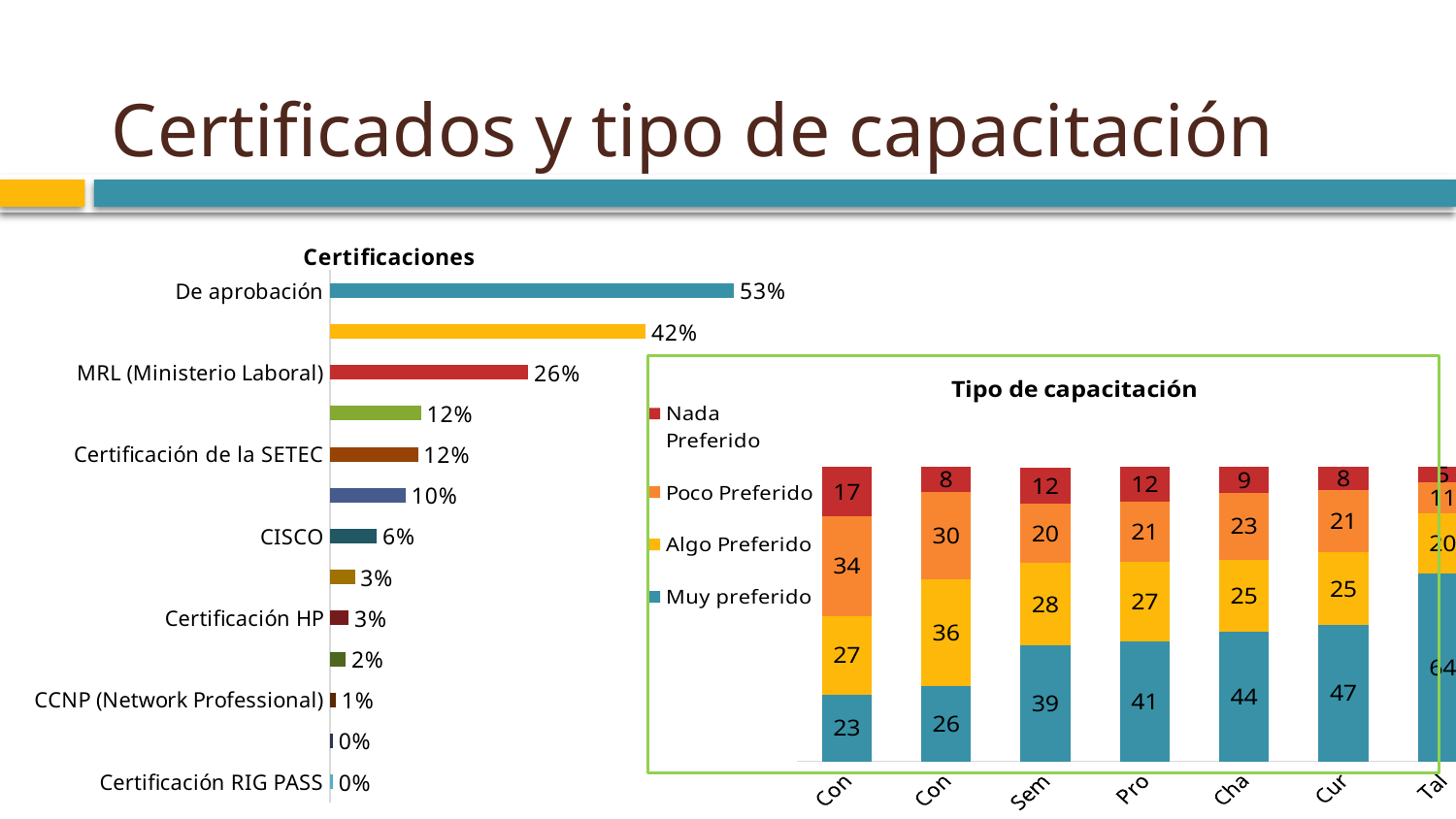
In the Tipo de capacitación chart, what is the total of the third bar from the left (labelled Sem)? 99 In the Tipo de capacitación chart, do the Muy preferido values rise or fall from left to right? Rise In the Certificaciones chart, what is the value for MRL (Ministerio Laboral)? 26% In the Certificaciones chart, which is larger: Certificación de la SETEC or Certificación HP? Certificación de la SETEC What kind of chart is the Certificaciones chart? Bar chart In the Certificaciones chart, what is the value for CISCO? 6% In the Certificaciones chart, what is the value for De aprobación? 53% In the Certificaciones chart, which labelled certification has the highest value? De aprobación How many series does the legend of the Tipo de capacitación chart list? 4 In the Tipo de capacitación chart, what is the Nada Preferido value for the first bar from the left? 17 In the Tipo de capacitación chart, what is the Muy preferido value for the sixth bar from the left (labelled Cur)? 47 In the Certificaciones chart, what is the difference between the values for De aprobación and MRL (Ministerio Laboral)? 27%